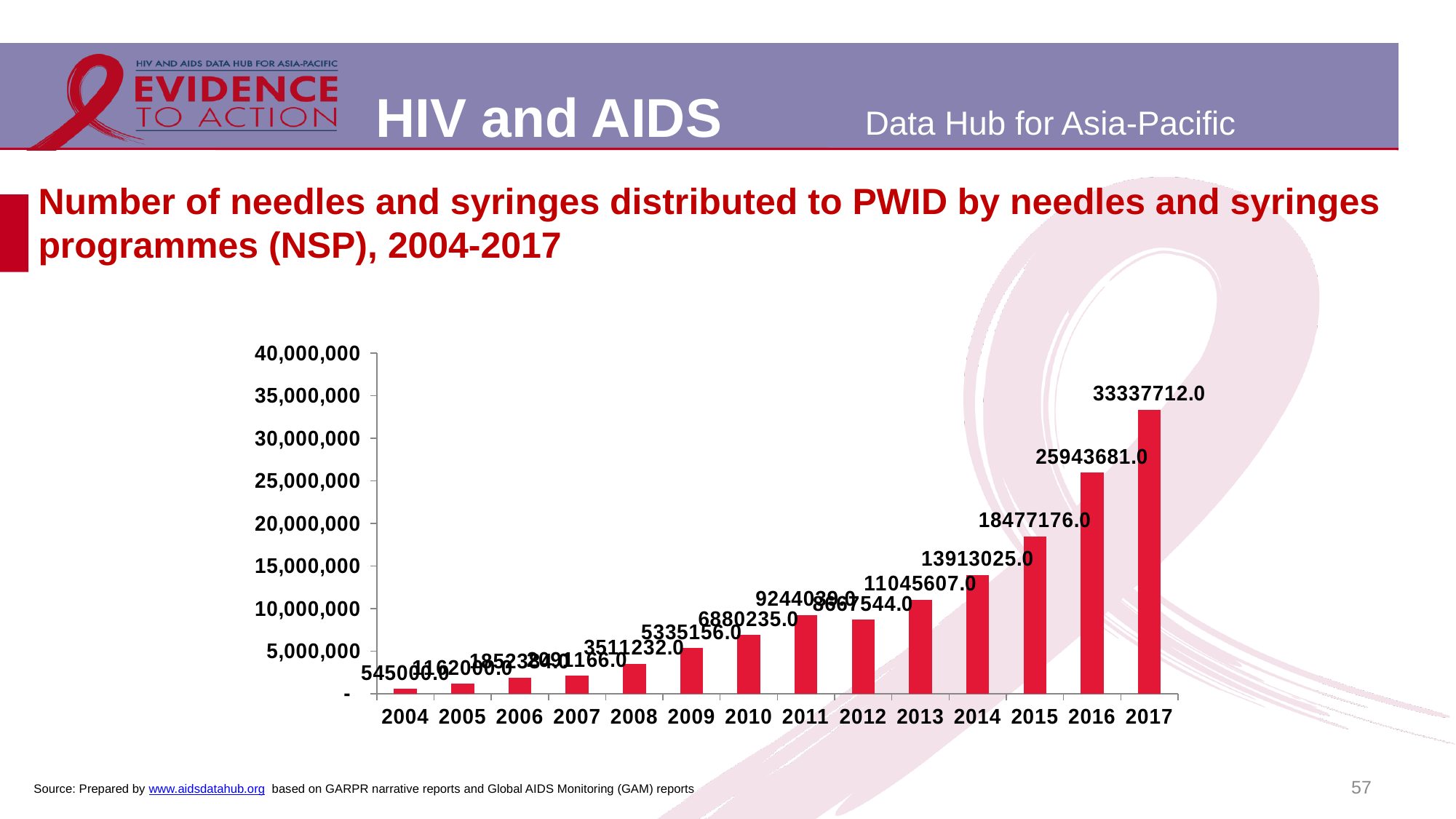
What is the difference between the values for 2017 and 2016? 7394031.0 Which year has the highest number of needles and syringes distributed? 2017 What type of chart is shown on the slide? Bar chart What is the number of needles and syringes distributed in 2016? 25943681.0 Overall, do the values rise or fall from 2004 to 2017? Rise Is the value for 2012 greater or less than 10,000,000? less Which year has the lowest number of needles and syringes distributed? 2004 How many years (bars) are plotted in the chart? 14 What is the number of needles and syringes distributed in 2004? 545000.0 What is the number of needles and syringes distributed in 2017? 33337712.0 What is the number of needles and syringes distributed in 2015? 18477176.0 What is the number of needles and syringes distributed in 2009? 5335156.0